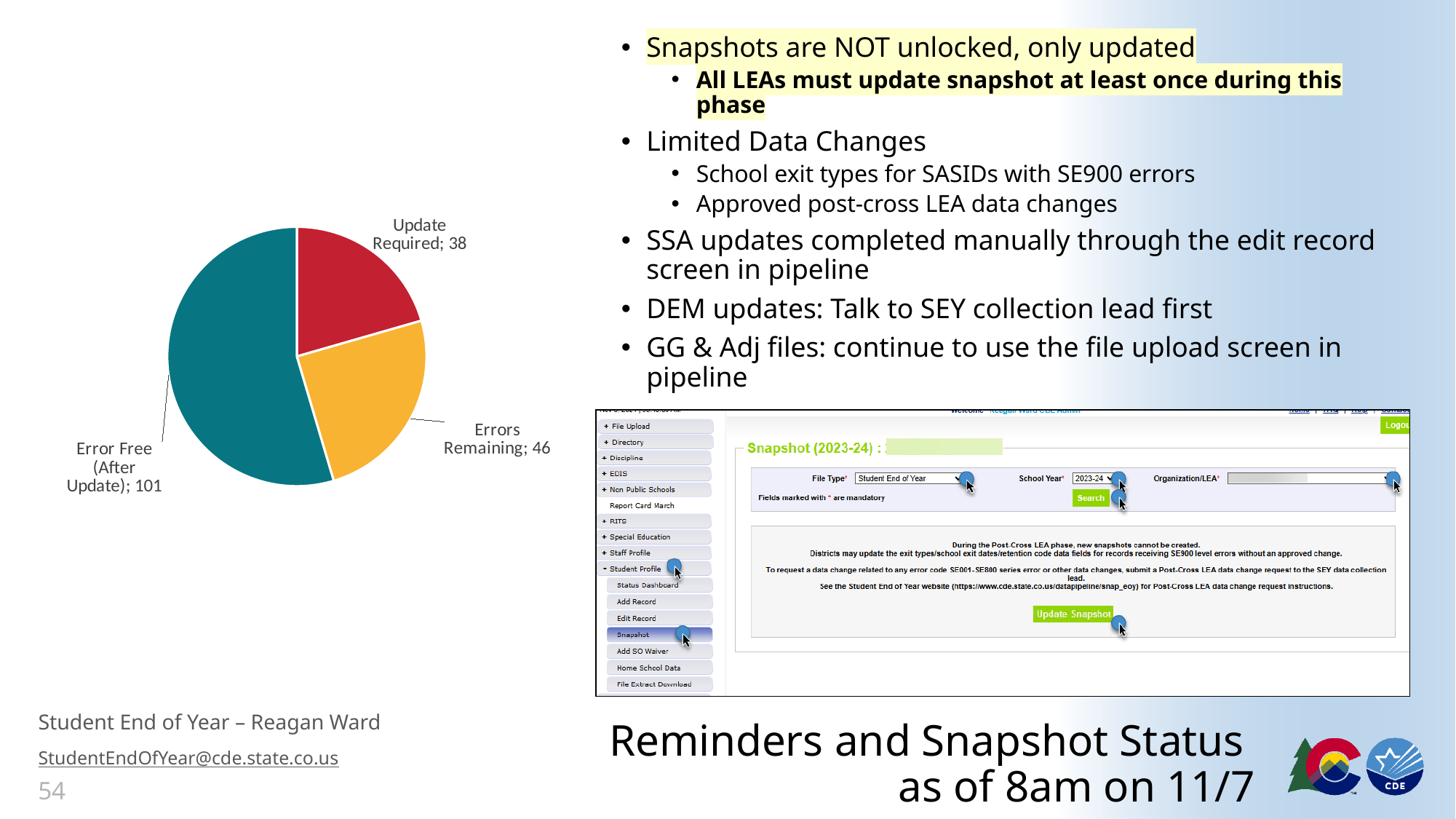
What kind of chart is shown on the left of the slide? Pie chart What is the value for Error Free (After Update) in the pie chart? 101 How many slices does the pie chart have? 3 What colour is the Error Free (After Update) slice in the pie chart? Teal Which slice of the pie chart is the largest? Error Free (After Update) Which is larger in the pie chart, Errors Remaining or Update Required? Errors Remaining What is the value for Update Required in the pie chart? 38 What is the difference between Errors Remaining and Update Required in the pie chart? 8 What is the difference between Error Free (After Update) and Errors Remaining in the pie chart? 55 Which slice of the pie chart is the smallest? Update Required What is the value for Errors Remaining in the pie chart? 46 What is the total of all slices in the pie chart? 185